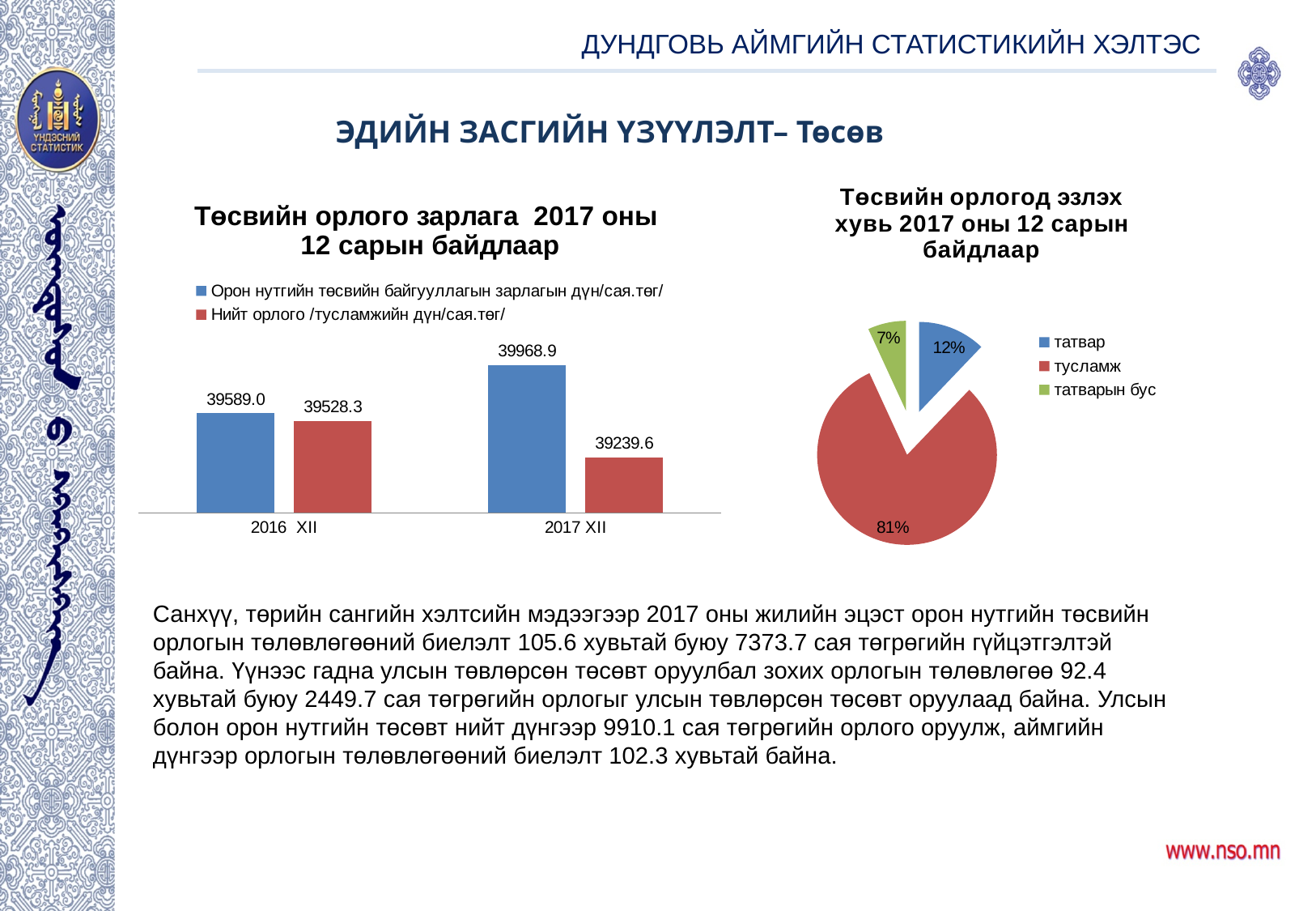
In the pie chart 'Төсвийн орлогод эзлэх хувь 2017 оны 12 сарын байдлаар', what colour is the 'татвар' slice? blue What kind of chart is 'Төсвийн орлогод эзлэх хувь 2017 оны 12 сарын байдлаар'? pie chart In the bar chart 'Төсвийн орлого зарлага 2017 оны 12 сарын байдлаар', what is the value of 'Орон нутгийн төсвийн байгууллагын зарлагын дүн/сая.төг/' for 2017 XII? 39968.9 In the pie chart 'Төсвийн орлогод эзлэх хувь 2017 оны 12 сарын байдлаар', what share does 'тусламж' have? 81% In the bar chart 'Төсвийн орлого зарлага 2017 оны 12 сарын байдлаар', how many series does the legend list? 2 In the bar chart 'Төсвийн орлого зарлага 2017 оны 12 сарын байдлаар', does 'Нийт орлого /тусламжийн дүн/сая.төг/' rise or fall from 2016 XII to 2017 XII? fall In the bar chart 'Төсвийн орлого зарлага 2017 оны 12 сарын байдлаар', what is the difference between the two series' values for 2017 XII? 729.3 In the bar chart 'Төсвийн орлого зарлага 2017 оны 12 сарын байдлаар', what is the value of 'Нийт орлого /тусламжийн дүн/сая.төг/' for 2016 XII? 39528.3 In the pie chart 'Төсвийн орлогод эзлэх хувь 2017 оны 12 сарын байдлаар', which slice is the smallest? татварын бус In the bar chart 'Төсвийн орлого зарлага 2017 оны 12 сарын байдлаар', how many categories are shown on the x axis? 2 In the bar chart 'Төсвийн орлого зарлага 2017 оны 12 сарын байдлаар', which is larger for 2016 XII: 'Орон нутгийн төсвийн байгууллагын зарлагын дүн/сая.төг/' or 'Нийт орлого /тусламжийн дүн/сая.төг/'? Орон нутгийн төсвийн байгууллагын зарлагын дүн/сая.төг/ In the bar chart 'Төсвийн орлого зарлага 2017 оны 12 сарын байдлаар', what is the value of 'Нийт орлого /тусламжийн дүн/сая.төг/' for 2017 XII? 39239.6